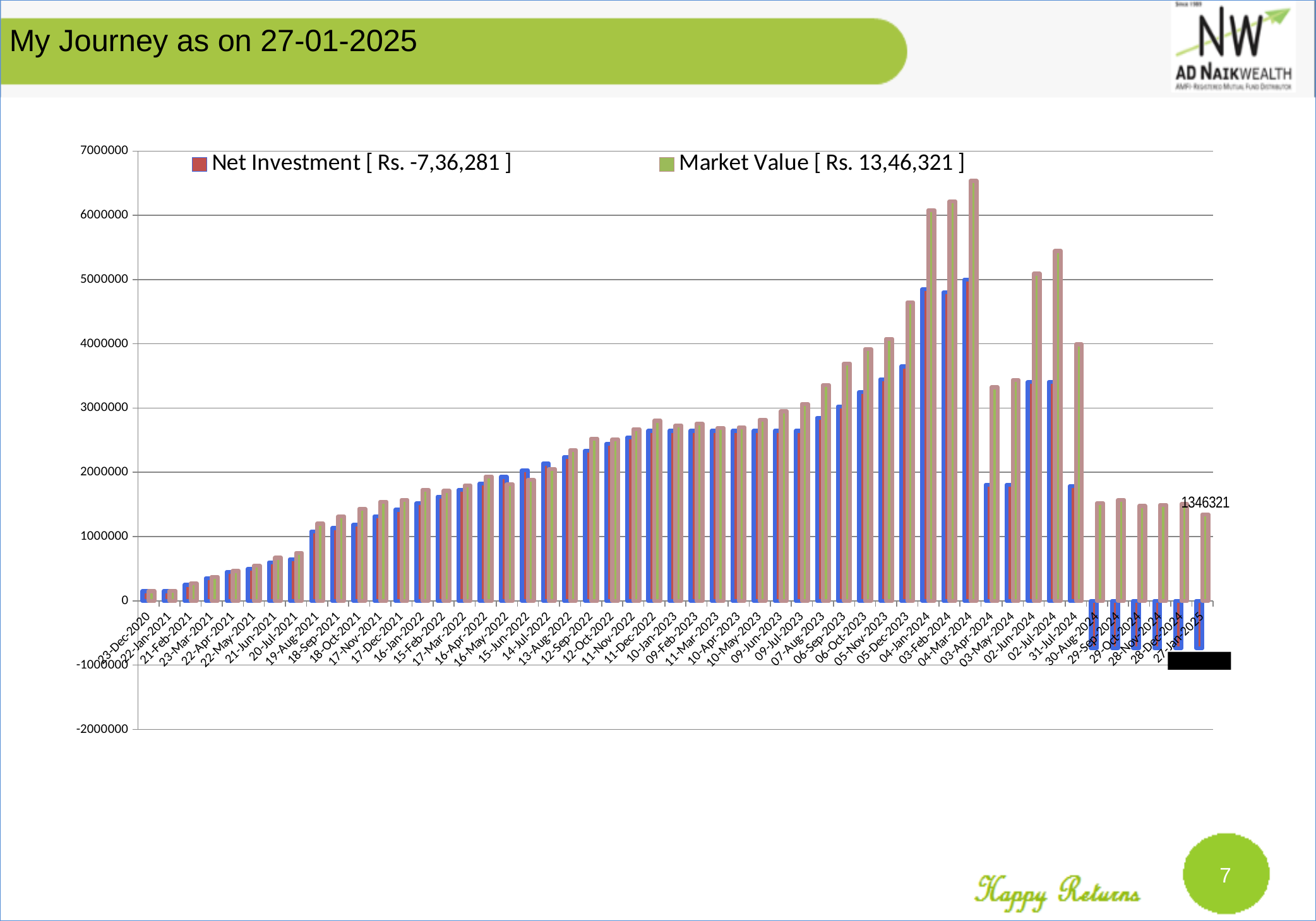
What Net Investment amount is shown in the legend entry? Rs. -7,36,281 What kind of chart is shown on the slide? bar chart Is the Net Investment on 27-Jan-2025 greater or less than 0? less On 03-Apr-2024, which is larger: Net Investment or Market Value? Market Value Is the Market Value on 04-Mar-2024 greater or less than 6000000? greater On which date is the Market Value highest? 04-Mar-2024 What is the title of the slide containing the chart? My Journey as on 27-01-2025 Is the Market Value on 02-Jul-2024 greater or less than 5000000? greater Does the Market Value rise or fall from 23-Dec-2020 to 04-Mar-2024? rise What is the Market Value on 27-Jan-2025 according to the data label? 1346321 How many series does the chart legend list? 2 On which date is the Net Investment highest? 04-Mar-2024